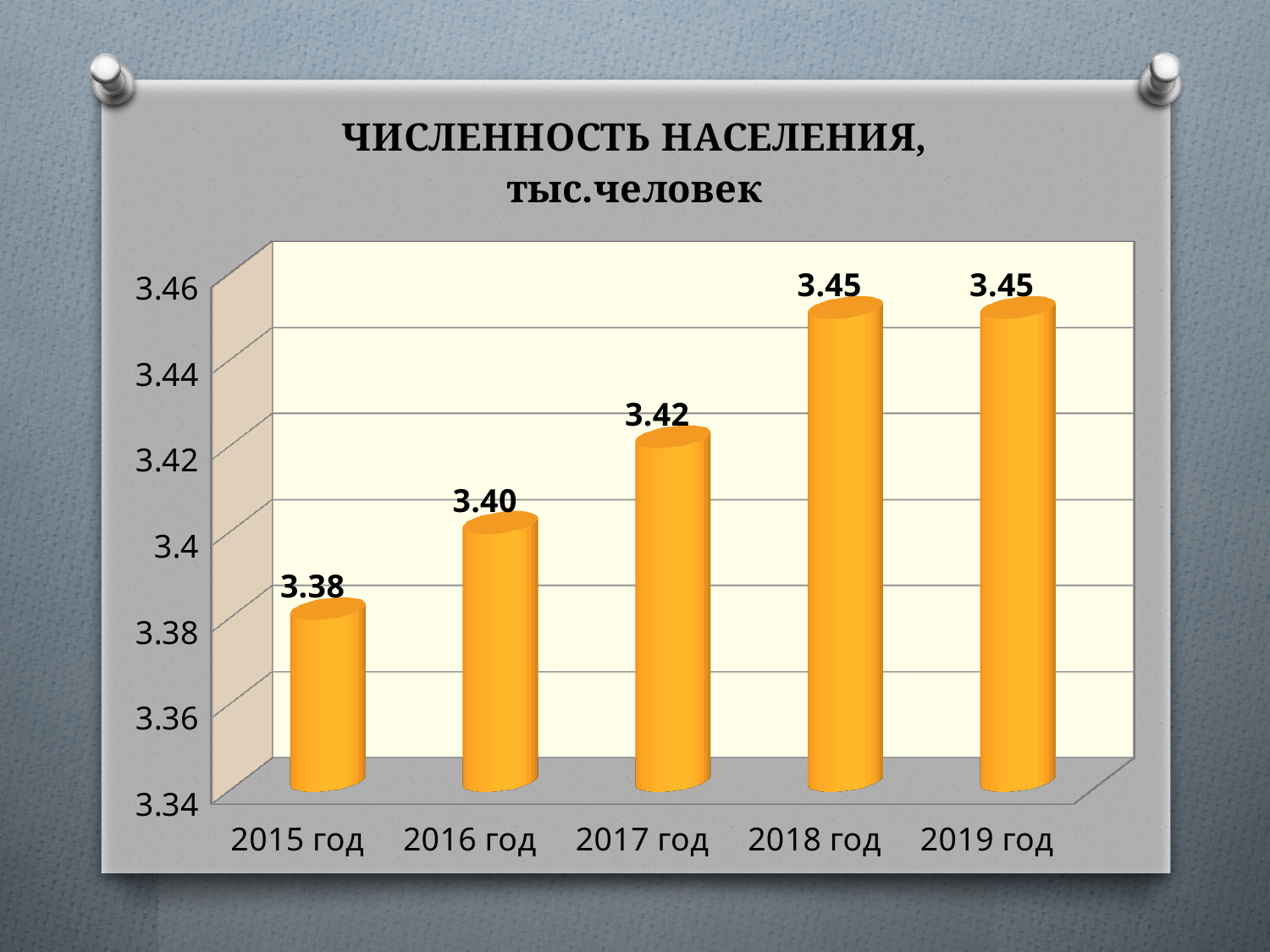
What is the population value shown for 2019 год? 3.45 How many years are shown on the x axis? 5 What kind of chart is shown on the slide? bar chart Which is larger, the value for 2016 год or the value for 2017 год? 2017 год What is the population value shown for 2017 год? 3.42 What is the difference between the values for 2018 год and 2015 год? 0.07 What is the population value shown for 2015 год? 3.38 What is the difference between the values for 2017 год and 2016 год? 0.02 What unit is given in the chart title? тыс.человек Do the values rise or fall from 2015 год to 2018 год? rise Which year has the lowest population value? 2015 год Is the value for 2016 год greater or less than 3.42? less